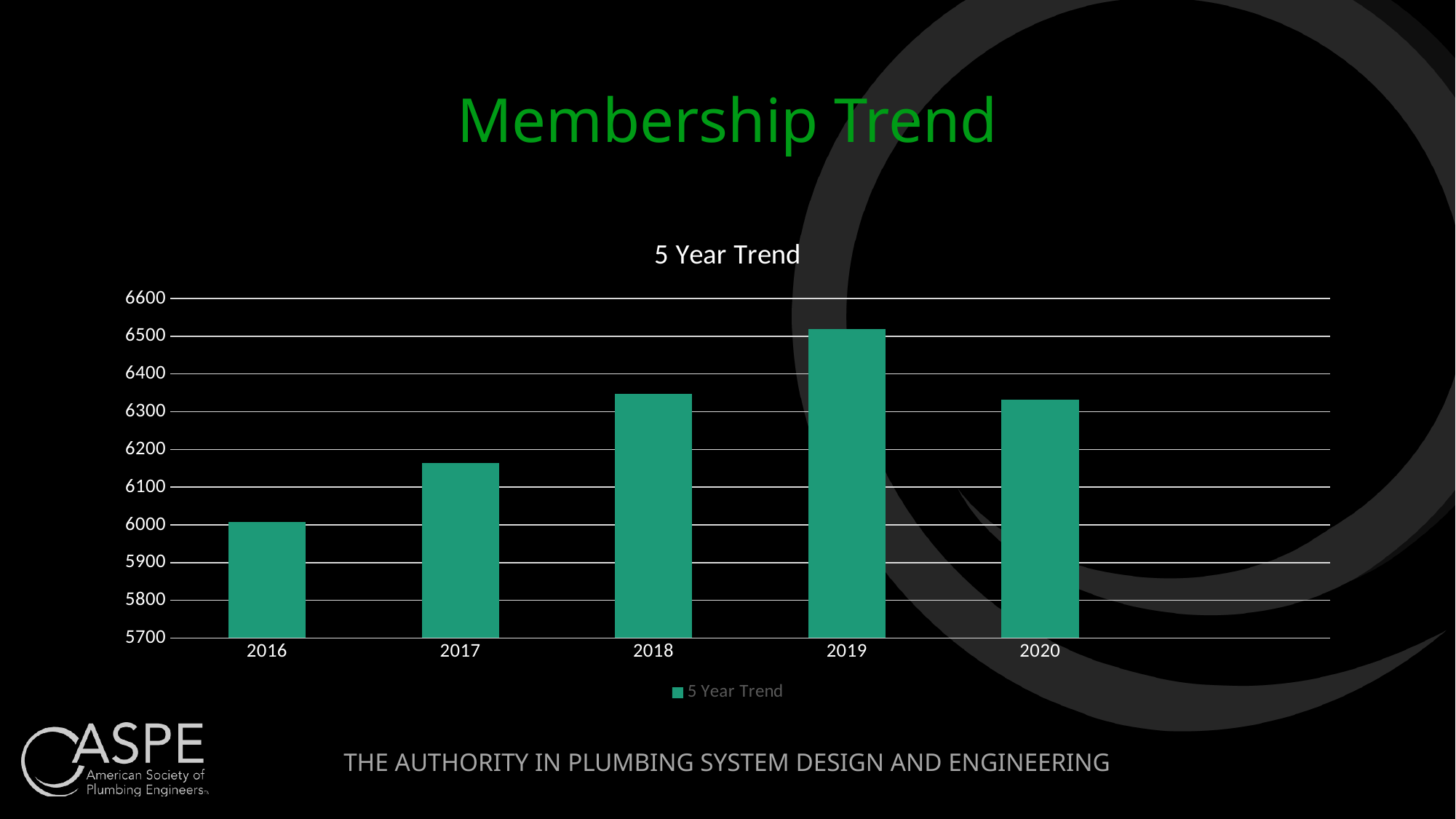
Is the value for 2016 greater or less than 6100? less Is the value for 2019 greater or less than 6400? greater Is the value for 2020 greater or less than 6400? less Which is larger, the value for 2017 or the value for 2019? 2019 Which year has the lowest membership value in the 5 Year Trend chart? 2016 What kind of chart is shown on the slide? bar chart How many years are plotted on the x axis of the chart? 5 What is the title shown above the chart's plot area? 5 Year Trend How many series does the legend list? 1 Which year has the highest membership value in the 5 Year Trend chart? 2019